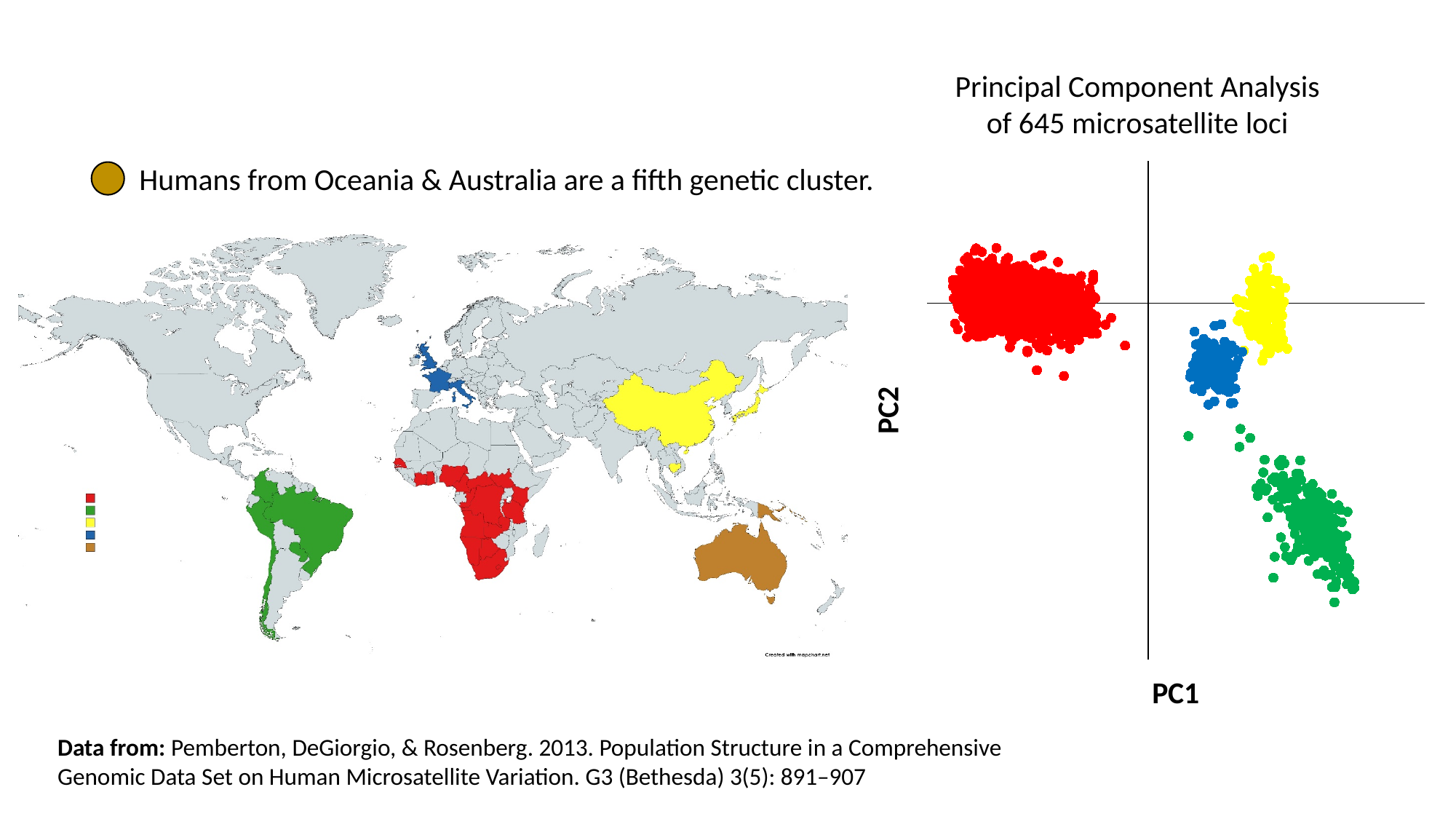
What kind of chart is shown on the right side of the slide? scatter plot In the scatter plot, which cluster is further right on PC1: the red cluster or the yellow cluster? yellow Which coloured cluster in the scatter plot lies furthest right on the PC1 axis? green What is the title of the scatter plot on the right? Principal Component Analysis of 645 microsatellite loci What is the label of the vertical axis of the scatter plot? PC2 Which coloured cluster in the scatter plot lies furthest left on the PC1 axis? red Which coloured cluster in the scatter plot lies lowest on the PC2 axis? green What is the label of the horizontal axis of the scatter plot? PC1 In the scatter plot, which cluster is higher on PC2: the yellow cluster or the blue cluster? yellow How many differently coloured clusters of points are plotted in the scatter plot? 4 In the scatter plot, which cluster is higher on PC2: the blue cluster or the green cluster? blue